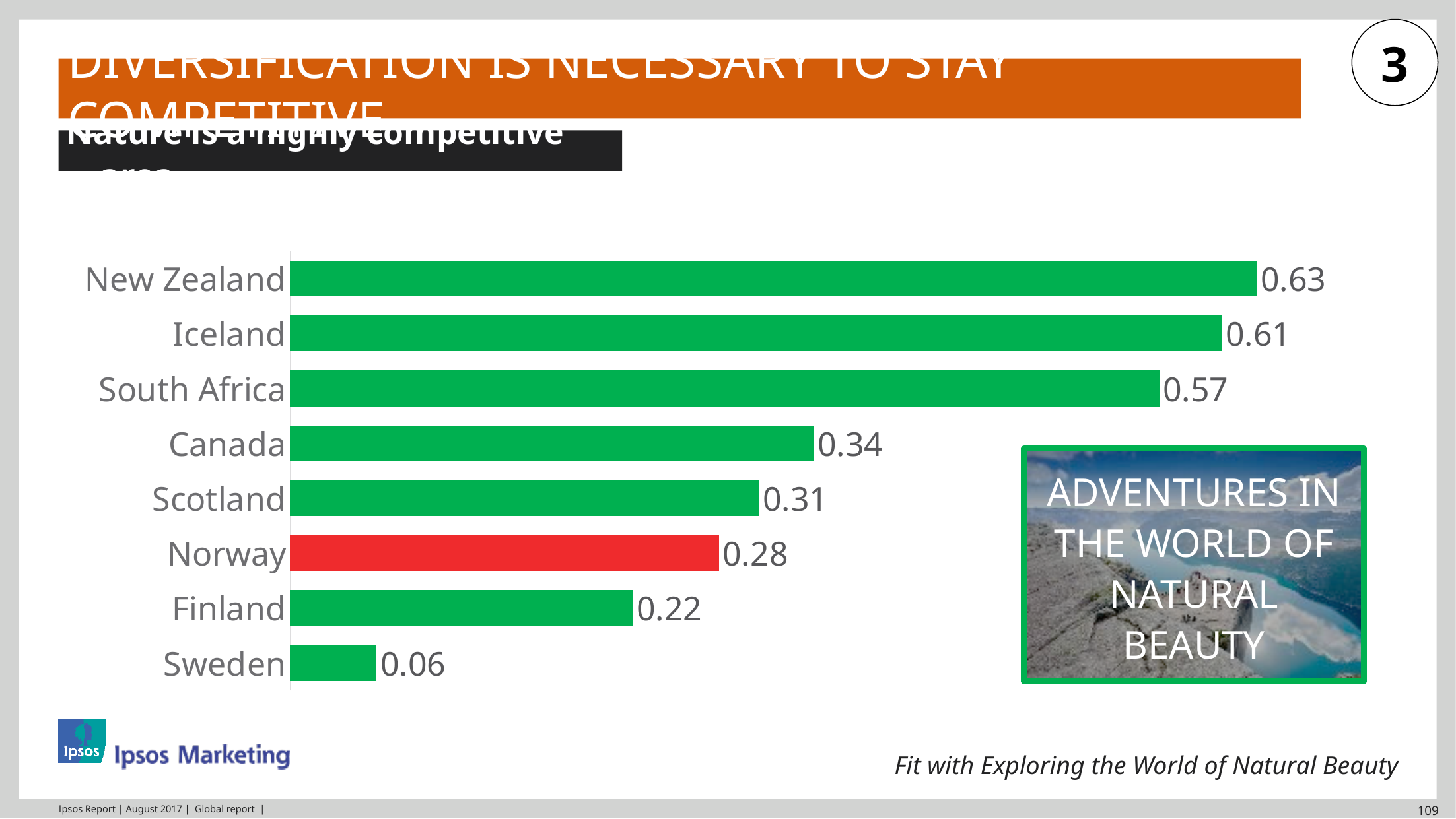
Which country has the lowest value? Sweden Which has a larger value, South Africa or Canada? South Africa What is the value for Norway? 0.28 Which country's bar is coloured red instead of green? Norway What is the difference between the values for Canada and Norway? 0.06 How many countries are shown in the chart? 8 Which has a larger value, Finland or Scotland? Scotland Which country has the highest value? New Zealand What is the difference between the values for New Zealand and Iceland? 0.02 What is the value for Sweden? 0.06 What is the value for New Zealand? 0.63 What kind of chart is shown on the slide? Bar chart